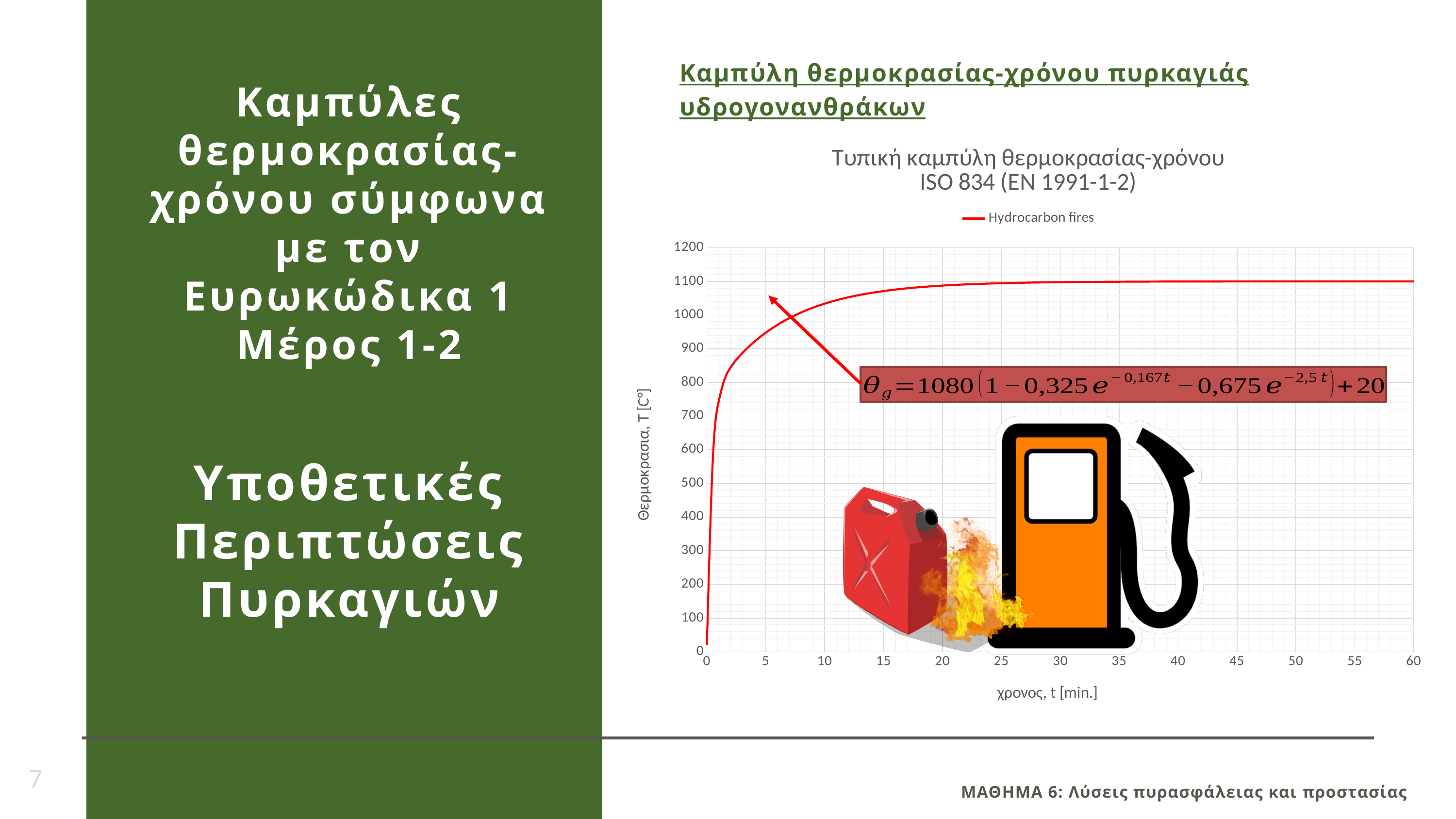
Which is larger: the temperature at 5 minutes or the temperature at 40 minutes? 40 minutes Does the temperature rise or fall as time increases along the x axis? rise How many series does the chart legend list? 1 What is the highest value shown on the y axis of the chart? 1200 What kind of chart is shown on the slide? line chart Is the temperature of the Hydrocarbon fires curve at 10 minutes greater or less than 900? greater Is the temperature of the Hydrocarbon fires curve at 45 minutes greater or less than 1000? greater Is the temperature of the Hydrocarbon fires curve at 0 minutes greater or less than 100? less What is the title of the chart? Τυπική καμπύλη θερμοκρασίας-χρόνου ISO 834 (EN 1991-1-2) What is the name of the series shown in the chart legend? Hydrocarbon fires